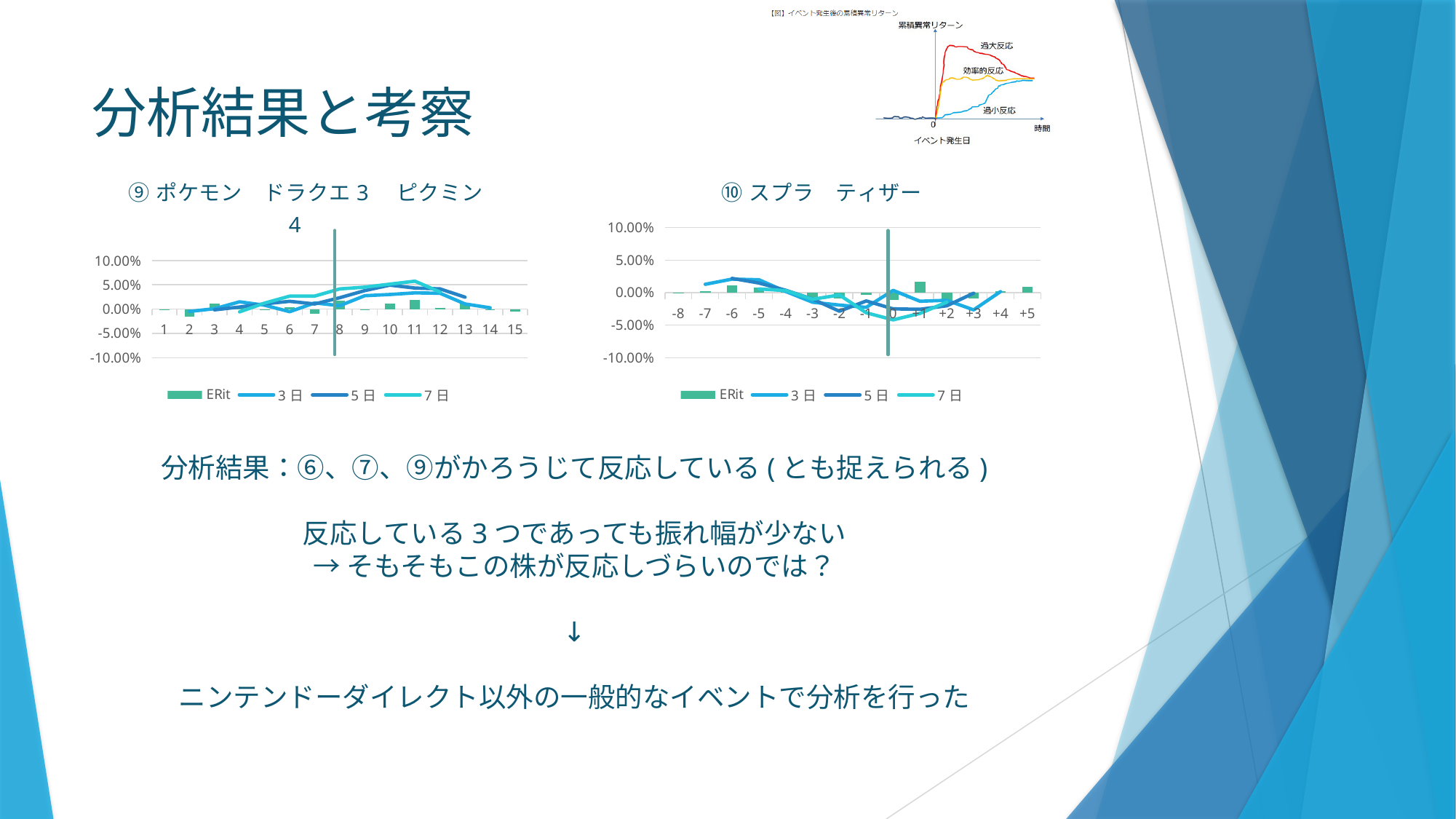
In the chart titled ⑨ ポケモン ドラクエ3 ピクミン4, is the 7日 value at category 11 greater or less than 10.00%? less In the chart titled ⑩ スプラ ティザー, is the 7日 value at category 0 greater or less than 0.00%? less How many series does the legend of the chart titled ⑩ スプラ ティザー list? 4 In the chart titled ⑨ ポケモン ドラクエ3 ピクミン4, how many categories are shown on the x axis? 15 In the chart titled ⑩ スプラ ティザー, is the ERit value at category +1 greater or less than 0.00%? greater In the chart titled ⑩ スプラ ティザー, what is the last category label on the x axis? +5 In the chart titled ⑩ スプラ ティザー, how many categories are shown on the x axis? 14 How many series does the legend of the chart titled ⑨ ポケモン ドラクエ3 ピクミン4 list? 4 In the chart titled ⑩ スプラ ティザー, what is the first category label on the x axis? -8 Which series in the chart titled ⑨ ポケモン ドラクエ3 ピクミン4 is drawn as bars rather than a line? ERit